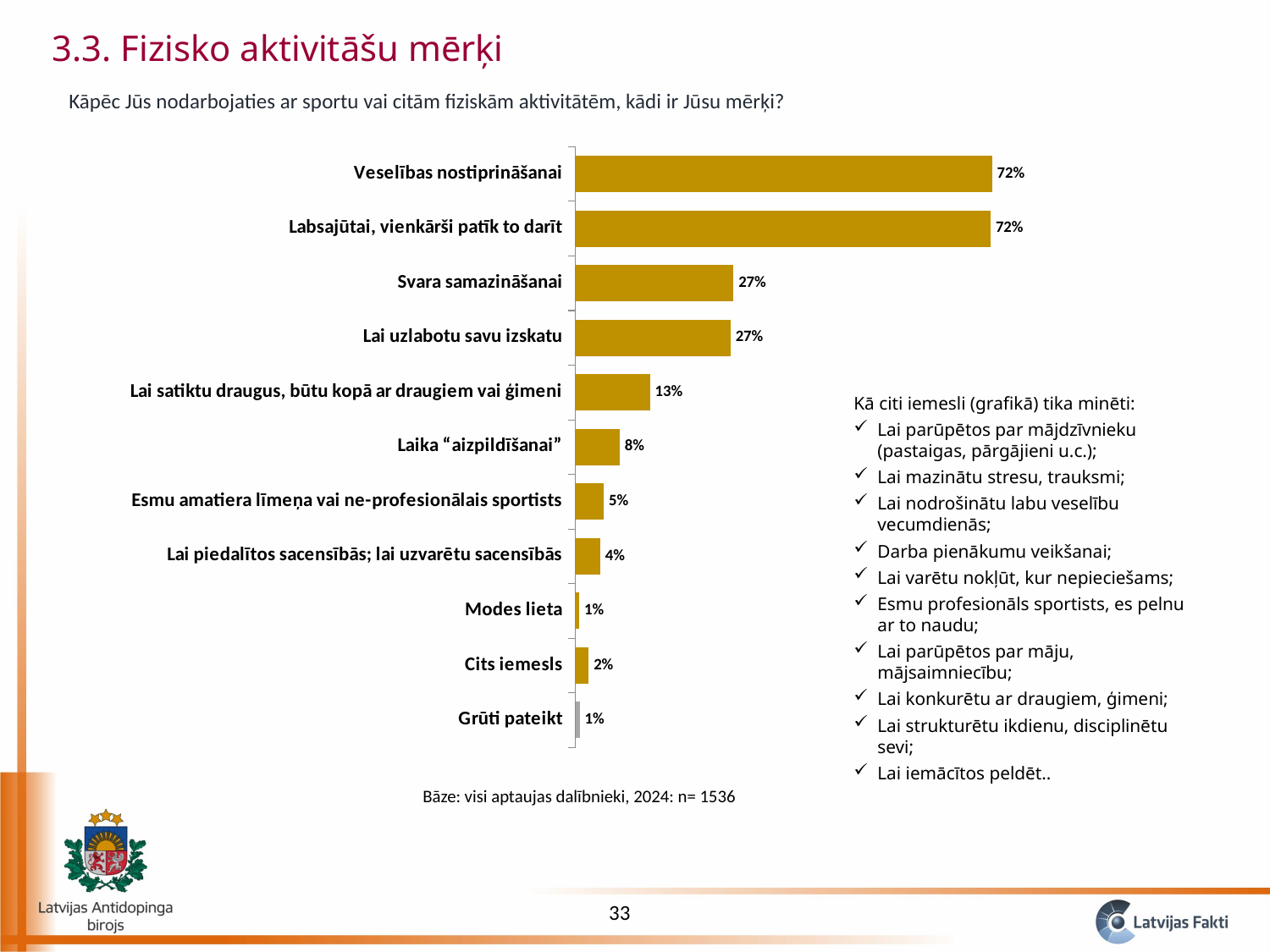
What is the value for "Laika "aizpildīšanai""? 8% What kind of chart is shown on the slide? Bar chart What is the value for "Cits iemesls"? 2% What percentage of respondents chose "Veselības nostiprināšanai" as a goal? 72% How many categories are shown in the chart? 11 What is the difference in percentage points between "Labsajūtai, vienkārši patīk to darīt" and "Lai uzlabotu savu izskatu"? 45 percentage points What is the value for "Grūti pateikt"? 1% What is the base (sample size) stated below the chart? n= 1536 Which is larger: the value for "Svara samazināšanai" or for "Lai satiktu draugus, būtu kopā ar draugiem vai ģimeni"? Svara samazināšanai What is the value shown for "Svara samazināšanai"? 27% What percentage is shown for "Esmu amatiera līmeņa vai ne-profesionālais sportists"? 5% What percentage is shown for "Lai satiktu draugus, būtu kopā ar draugiem vai ģimeni"? 13%